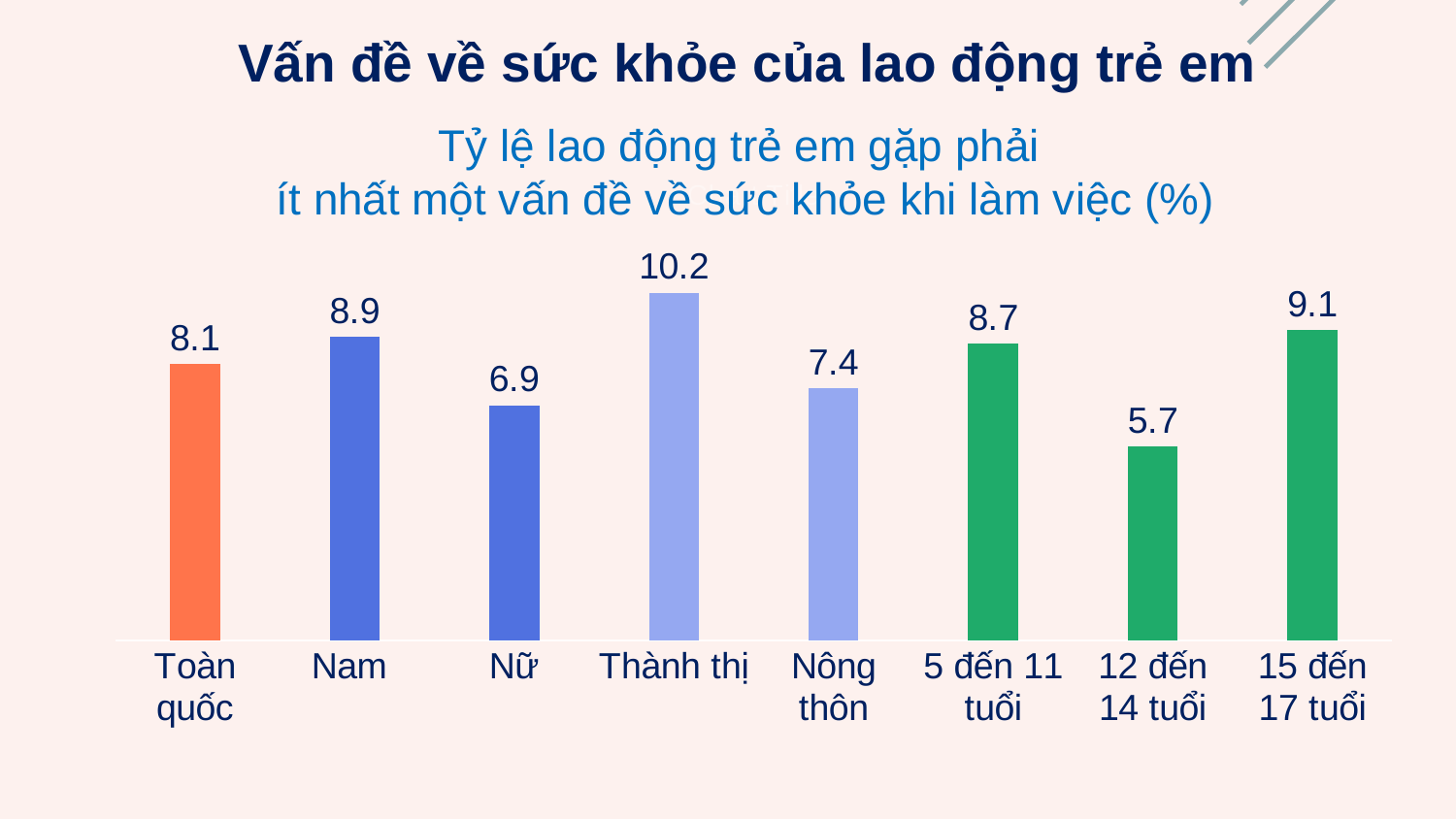
What is the value for Thành thị? 10.2 What is the difference between the values for Thành thị and Nông thôn? 2.8 What kind of chart is shown on the slide? Bar chart What is the difference between the values for Nam and Nữ? 2.0 Which is larger, the value for 5 đến 11 tuổi or the value for 15 đến 17 tuổi? 15 đến 17 tuổi What is the chart's title? Tỷ lệ lao động trẻ em gặp phải ít nhất một vấn đề về sức khỏe khi làm việc (%) What colour is the bar for Toàn quốc? Orange Which category has the lowest value? 12 đến 14 tuổi What is the value for Toàn quốc? 8.1 Which category has the highest value? Thành thị What is the value for 12 đến 14 tuổi? 5.7 How many categories are shown in the chart? 8